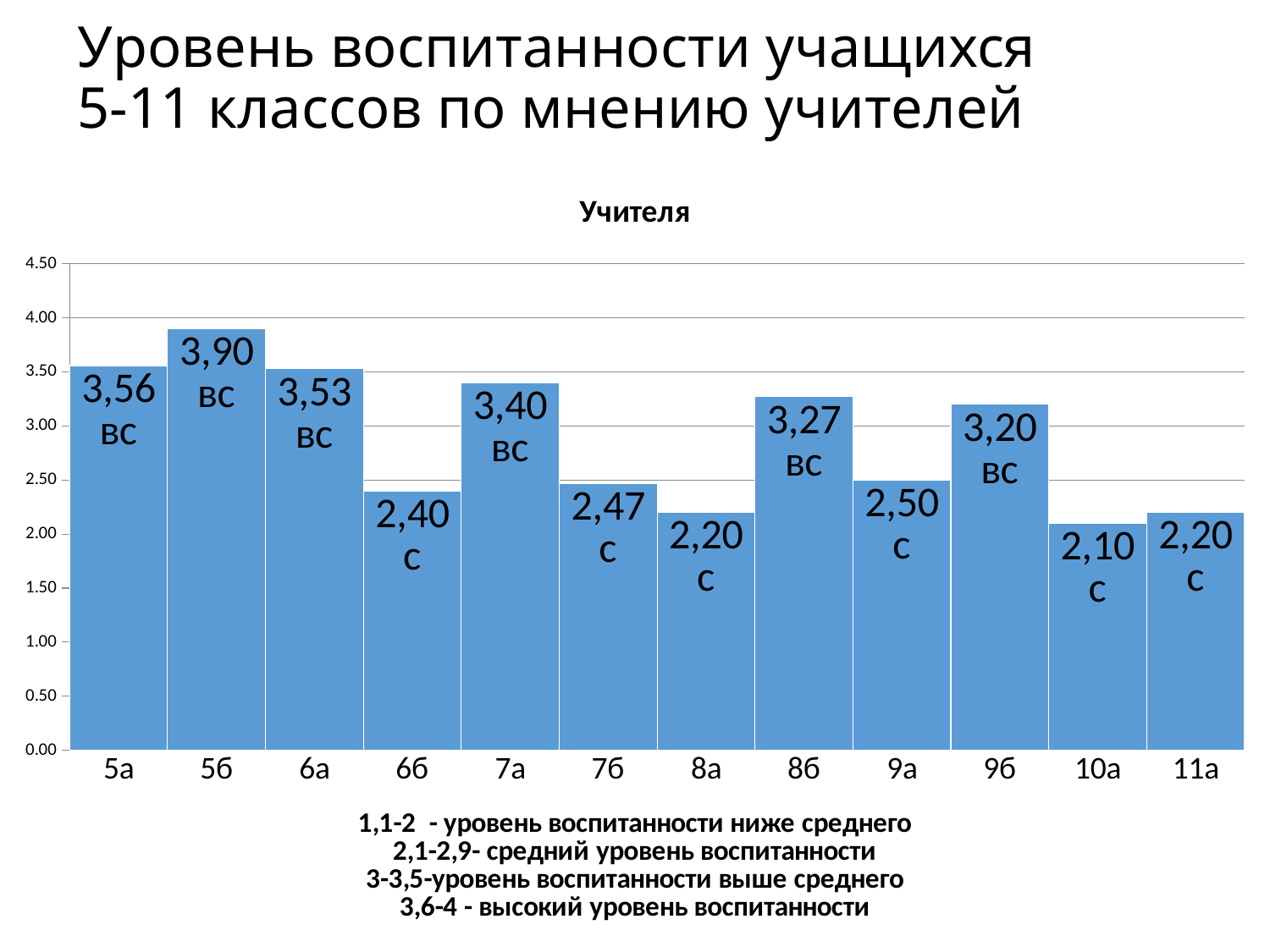
Which class has the lowest value in the chart? 10а What kind of chart is shown on the slide? bar chart What is the difference between the values for 5б and 6б? 1,50 How many classes are shown on the x axis? 12 Which class has the highest value in the chart? 5б What is the value shown for class 7а? 3,40 Which has the larger value, 6а or 9б? 6а Is the value for 8а greater or less than 3.00? less What is the title printed above the chart? Учителя What is the value shown for class 10а? 2,10 What is the value shown for class 5б? 3,90 What is the difference between the values for 8б and 9а? 0,77